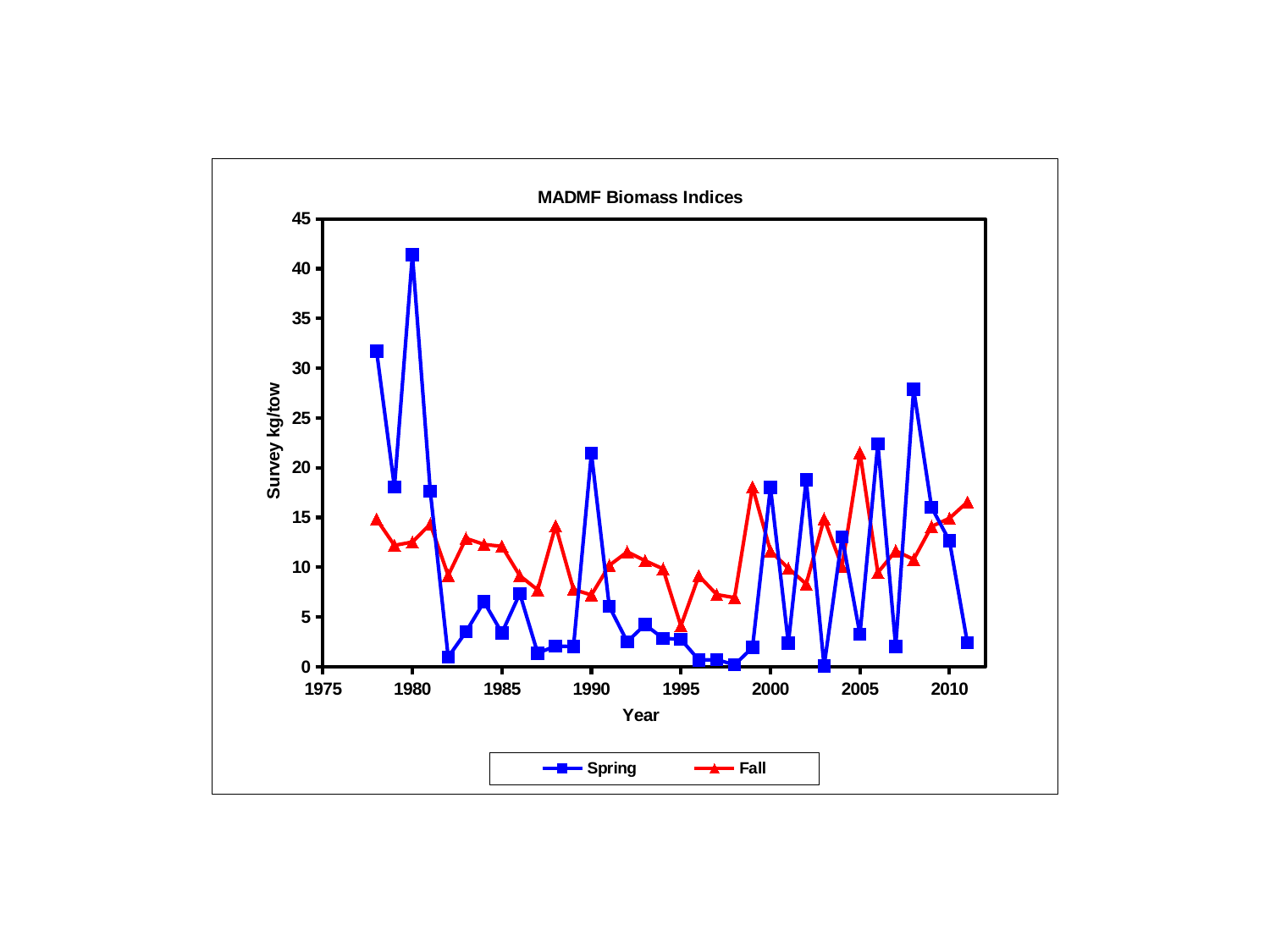
In 1990, which series has the higher value, Spring or Fall? Spring Is the Spring value in 2008 greater or less than 25? greater What kind of chart is shown on the slide? line chart What is the title of the chart? MADMF Biomass Indices In which year does the Spring series reach its highest value? 1980 How many series does the legend list? 2 In which year does the Fall series reach its highest value? 2005 Is the Spring value in 1982 greater or less than 5? less What is the label on the vertical axis? Survey kg/tow In 2005, which series has the higher value, Spring or Fall? Fall Is the Spring value in 1980 greater or less than 40? greater